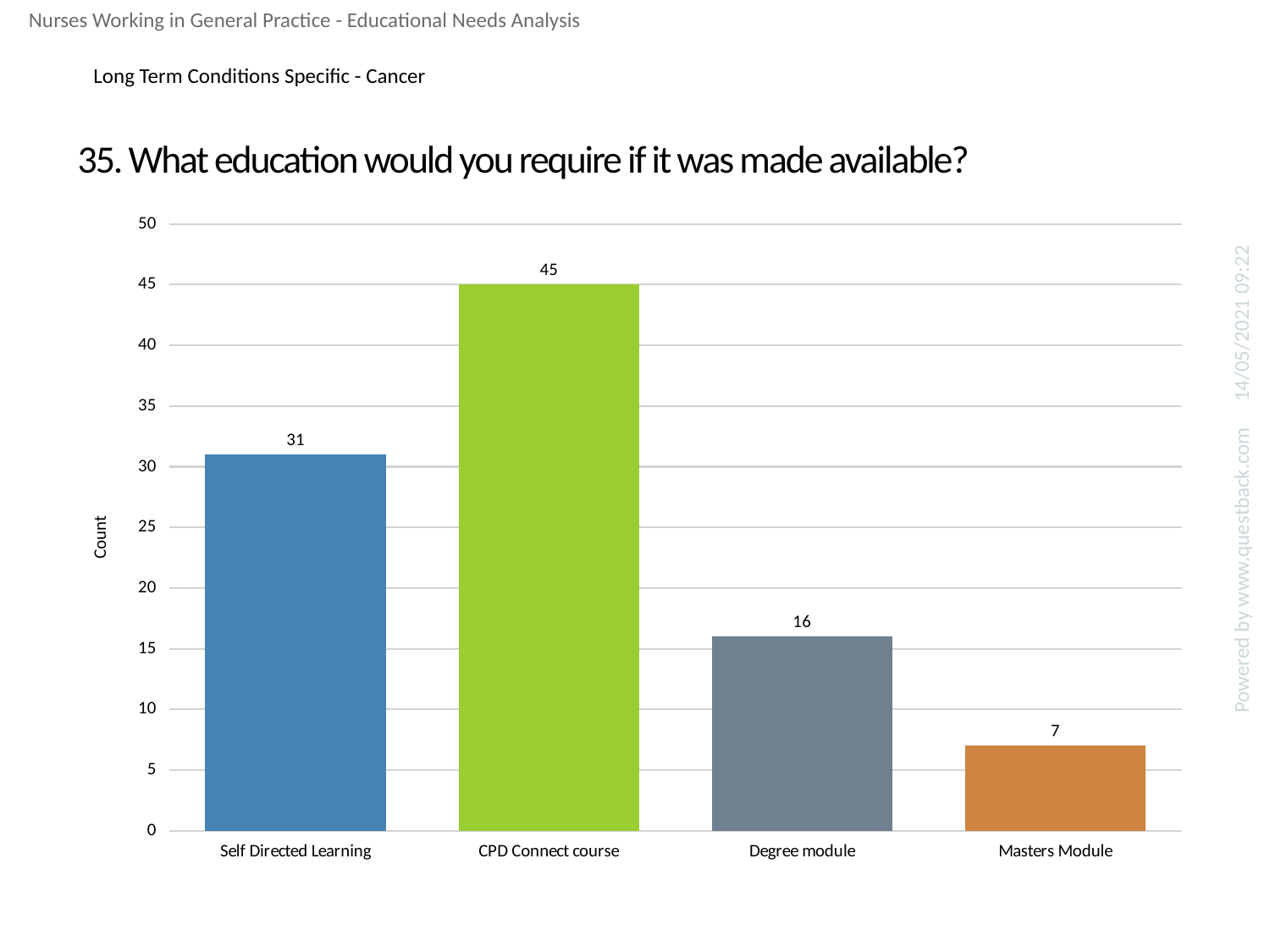
What is the difference between the counts for CPD Connect course and Self Directed Learning? 14 How many categories are shown on the x axis? 4 Which has a larger count, Self Directed Learning or Degree module? Self Directed Learning Which category has the lowest count? Masters Module What kind of chart is shown on the slide? Bar chart What is the count for Degree module? 16 What is the count for Masters Module? 7 What is the difference between the counts for Degree module and Masters Module? 9 What is the label of the y axis? Count What is the count for CPD Connect course? 45 Which category has the highest count? CPD Connect course What is the count for Self Directed Learning? 31